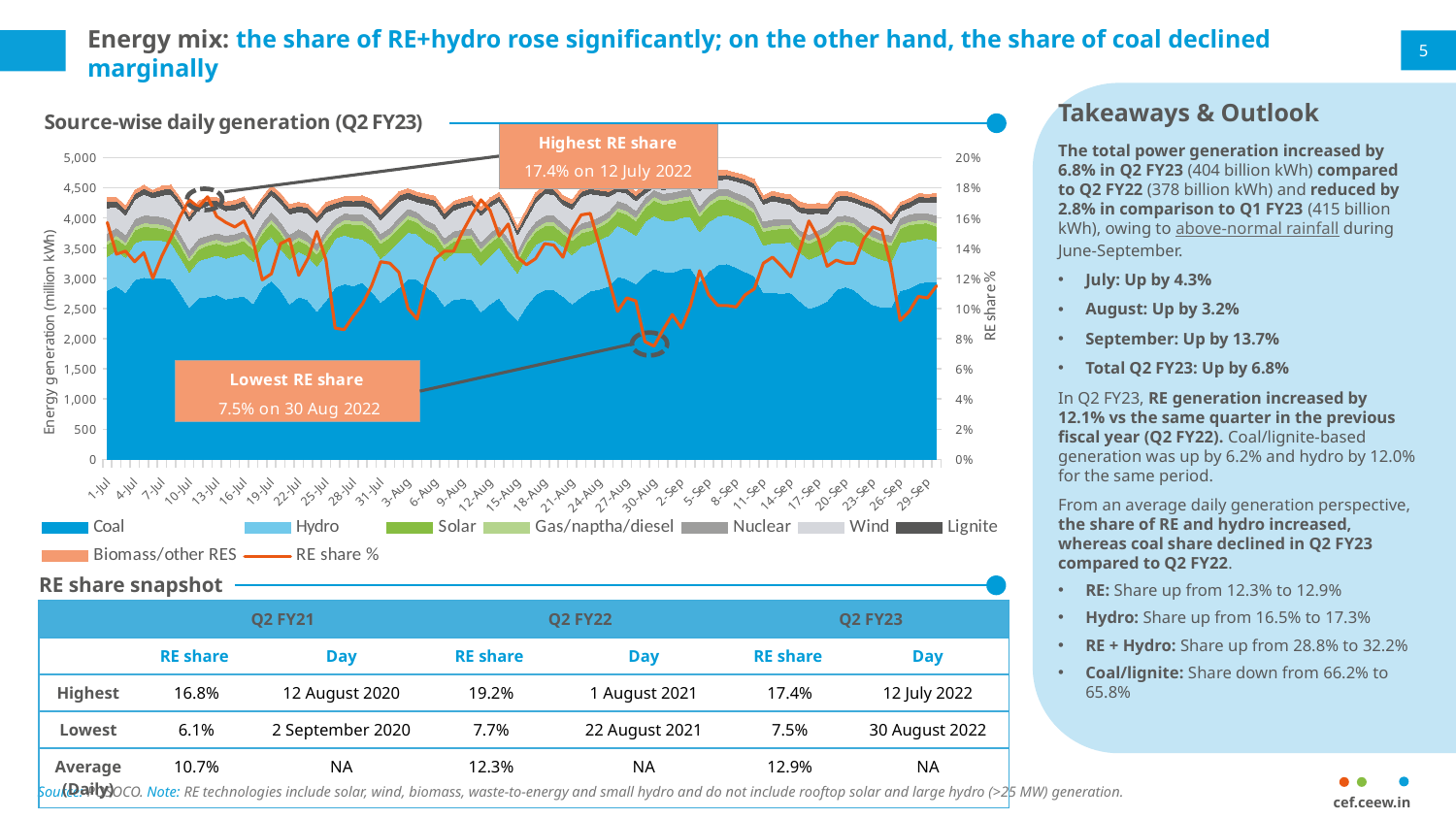
What is the label of the left vertical axis of the chart? Energy generation (million kWh) Is the coal generation on 1-Jul greater or less than 2,000 million kWh? greater What kind of chart is used to show source-wise daily generation? Stacked area chart with a line for RE share % What is the difference between the highest and lowest RE share shown in the chart annotations? 9.9 percentage points What is the title of the chart on the slide? Source-wise daily generation (Q2 FY23) How many series does the chart's legend list? 9 What was the lowest RE share in Q2 FY23 according to the chart annotation? 7.5% Which series contributes more to daily generation in the chart, Coal or Hydro? Coal Is the total stacked generation on 1-Jul greater or less than 3,500 million kWh? greater On which date did the lowest RE share occur according to the chart annotation? 30 Aug 2022 On which date did the highest RE share occur according to the chart annotation? 12 July 2022 What was the highest RE share in Q2 FY23 according to the chart annotation? 17.4%